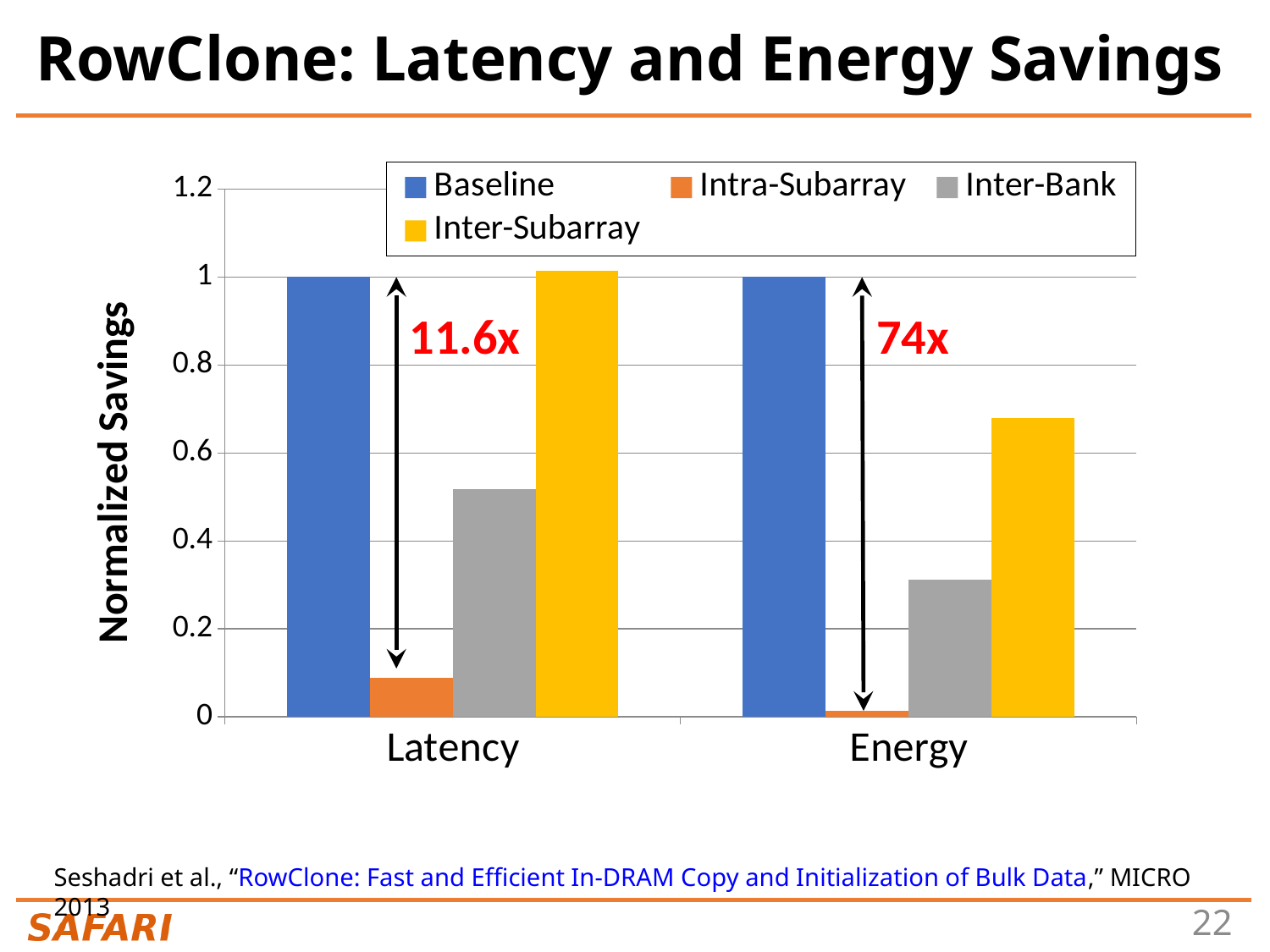
How many series does the legend list? 4 Is the Inter-Bank value for Energy greater or less than 0.4? less Which series has the lowest value for Latency? Intra-Subarray Is the Inter-Bank value for Latency greater or less than 0.6? less Which series has the lowest value for Energy? Intra-Subarray What is the Baseline value for Latency? 1 Is the Inter-Bank value larger for Latency or for Energy? Latency Is the Inter-Subarray value for Energy greater or less than 0.6? greater What is the Baseline value for Energy? 1 Which series has the highest value for Energy? Baseline What kind of chart is shown on the slide? bar chart How many categories are shown on the x axis? 2